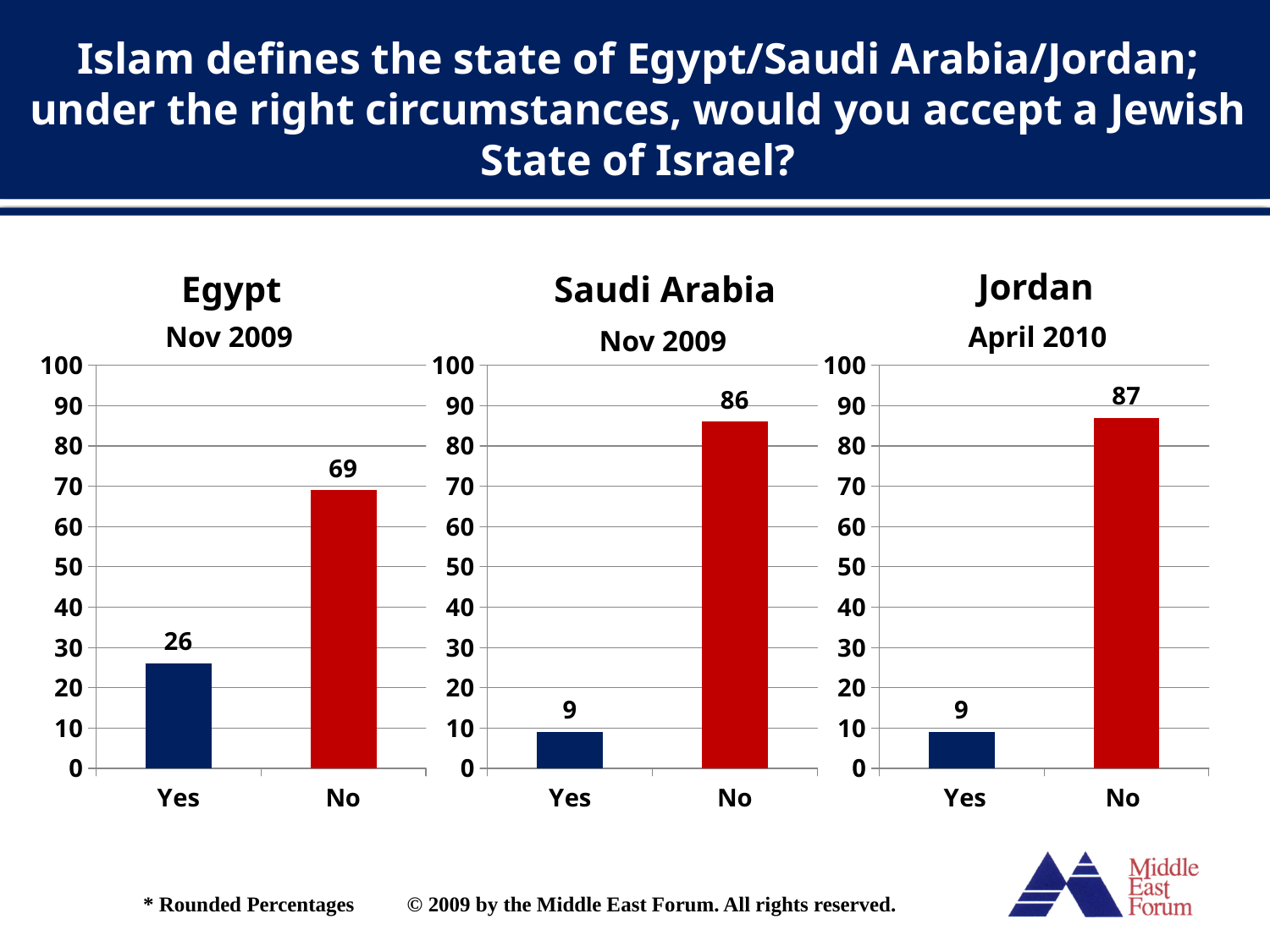
How many categories are shown in the Saudi Arabia chart? 2 In the Jordan chart, which category has the higher value, Yes or No? No In the Saudi Arabia chart, what is the value for No? 86 In the Jordan chart, what is the value for No? 87 What date is shown under the Jordan chart title? April 2010 In the Egypt chart, what is the value for Yes? 26 In the Egypt chart, what is the value for No? 69 What type of chart is the Jordan chart? Bar chart In the Saudi Arabia chart, what is the difference between the No and Yes values? 77 In the Jordan chart, what is the value for Yes? 9 In the Egypt chart, what is the difference between the No and Yes values? 43 In the Egypt chart, which category has the lowest value? Yes